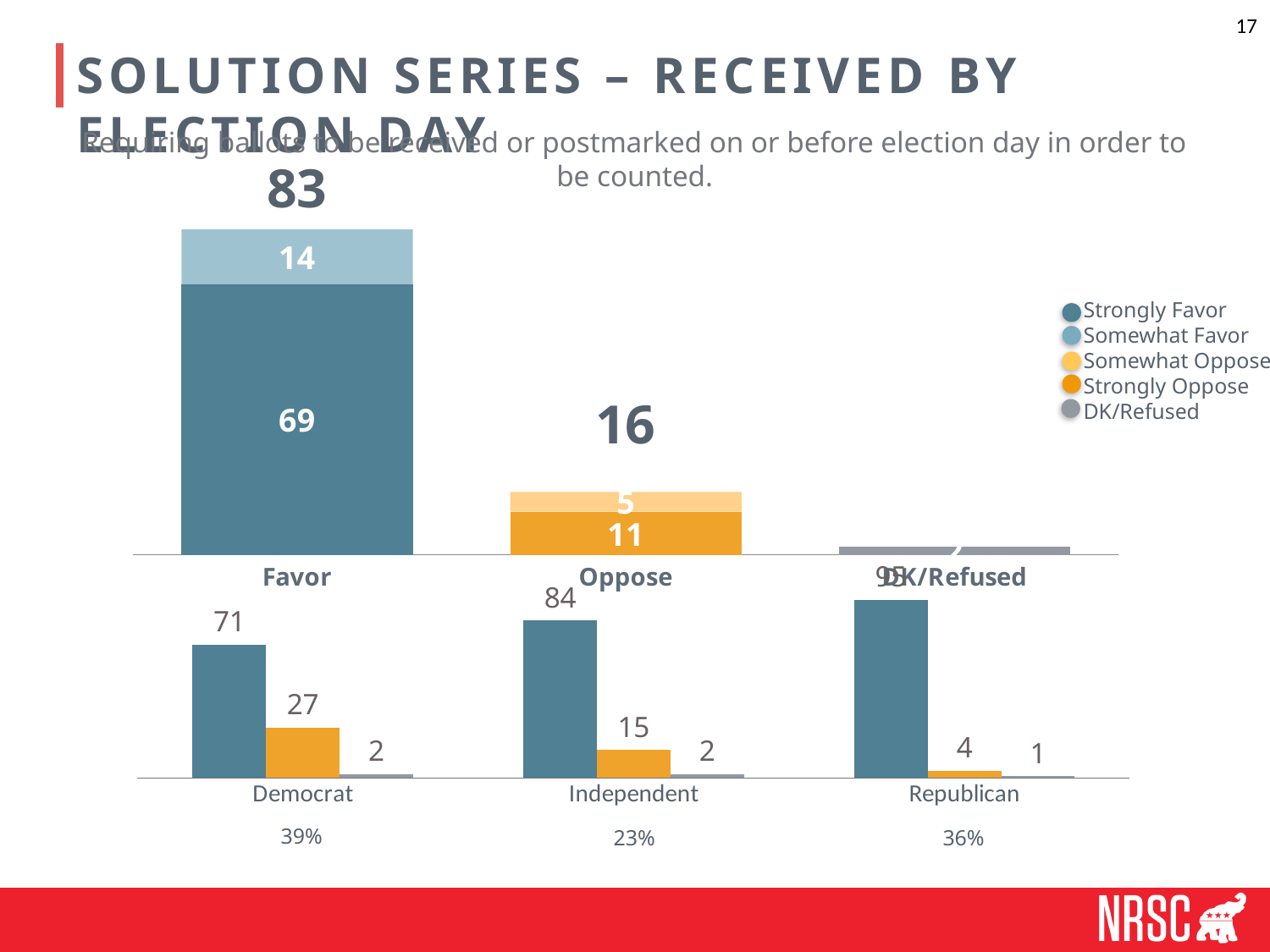
In the top chart, what is the Somewhat Favor value within the Favor bar? 14 How many series does the legend of the top chart list? 5 In the bottom chart, what is the value of the first (dark blue) bar for Democrat? 71 In the top chart, what is the total value shown above the Oppose bar? 16 In the bottom chart, which party has the highest orange bar value? Democrat In the top chart, what is the total value shown above the Favor bar? 83 In the top chart, what is the difference between the Favor total and the Oppose total? 67 In the top chart, what is the Strongly Favor value within the Favor bar? 69 In the bottom chart, what is the value of the orange bar for Independent? 15 In the top chart, what is the Strongly Oppose value within the Oppose bar? 11 In the bottom chart, what is the value of the orange bar for Republican? 4 In the bottom chart, what is the difference between the orange bar values for Democrat and Independent? 12